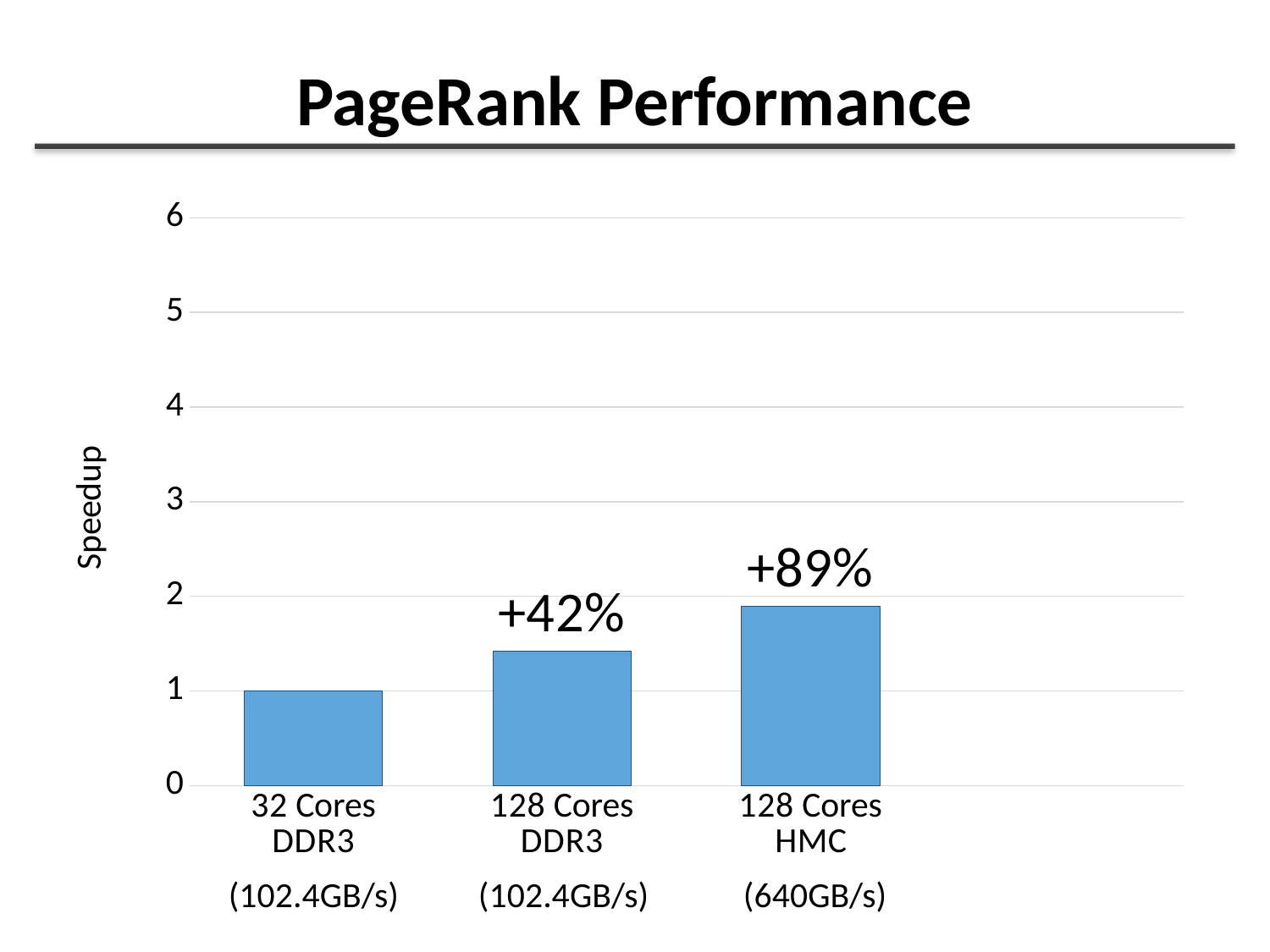
Which configuration has the lowest speedup? 32 Cores DDR3 What percentage improvement is labelled above the 128 Cores HMC bar? +89% What is the speedup value for 32 Cores DDR3? 1 Which configuration has the highest speedup? 128 Cores HMC How many bars are plotted in the chart? 3 What type of chart is shown on the slide? bar chart Is the speedup for 128 Cores DDR3 greater or less than 2? less What is the label on the vertical axis of the chart? Speedup Which has a larger speedup, 128 Cores DDR3 or 128 Cores HMC? 128 Cores HMC Do the speedup values rise or fall from left to right across the bars? rise What percentage improvement is labelled above the 128 Cores DDR3 bar? +42% Is the speedup for 128 Cores HMC greater or less than 1? greater